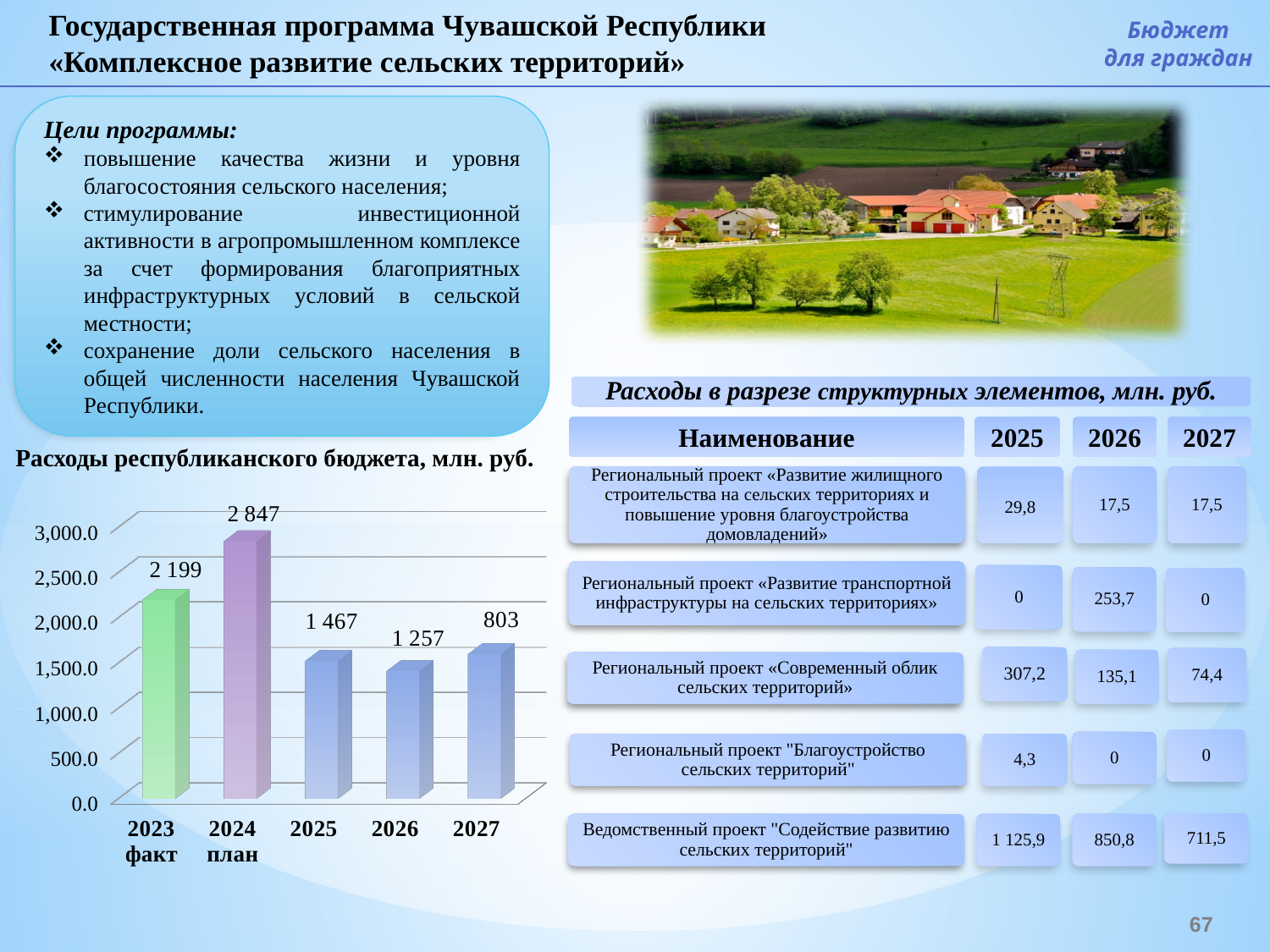
What is the difference between the values for 2024 план and 2023 факт in the bar chart? 648 What is the value for 2027 in the bar chart? 803 What is the value for 2026 in the bar chart? 1 257 Which year has the highest value in the bar chart? 2024 план How many categories (years) are shown in the bar chart? 5 What is the value for 2024 план in the chart 'Расходы республиканского бюджета, млн. руб.'? 2 847 What kind of chart is used for 'Расходы республиканского бюджета, млн. руб.'? bar chart What is the difference between the values for 2025 and 2026 in the bar chart? 210 What is the value for 2023 факт in the bar chart? 2 199 Which is larger in the bar chart, the value for 2025 or the value for 2026? 2025